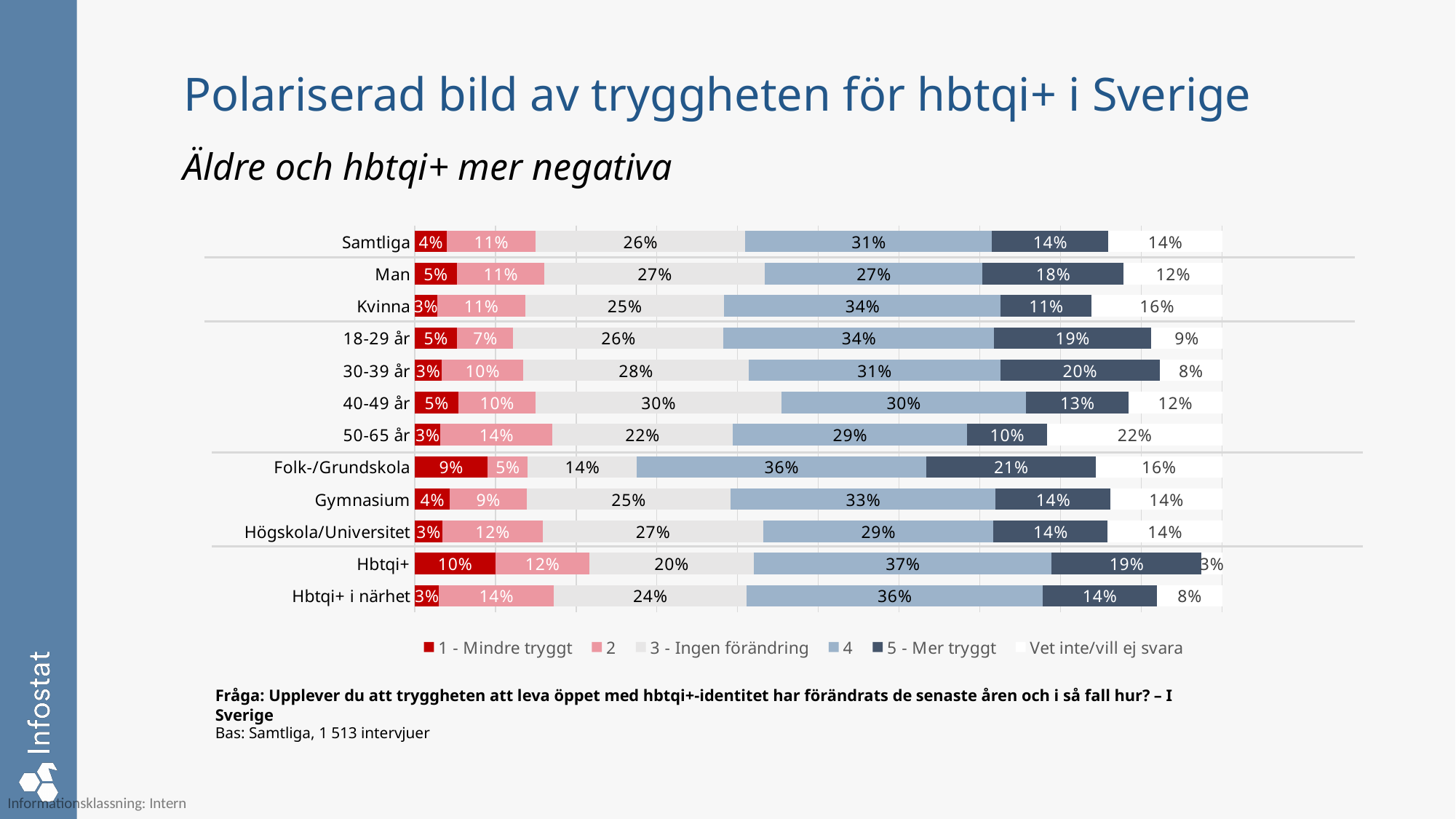
What kind of chart is shown on the slide? Stacked bar chart What is the value of '5 - Mer tryggt' for Man? 18% Which category has the lowest value for 'Vet inte/vill ej svara'? Hbtqi+ What is the total of the stacked bar for Samtliga? 100% How many categories (rows) does the chart show? 12 What is the value of 'Vet inte/vill ej svara' for 50-65 år? 22% What is the difference between the '1 - Mindre tryggt' value for Hbtqi+ and for Samtliga? 6 percentage points Which category has the highest value for '1 - Mindre tryggt'? Hbtqi+ How many series does the legend list? 6 Which is larger: the '4' value for Kvinna or for Man? Kvinna Which category has the highest value for '5 - Mer tryggt'? Folk-/Grundskola What is the value of '3 - Ingen förändring' for Folk-/Grundskola? 14%